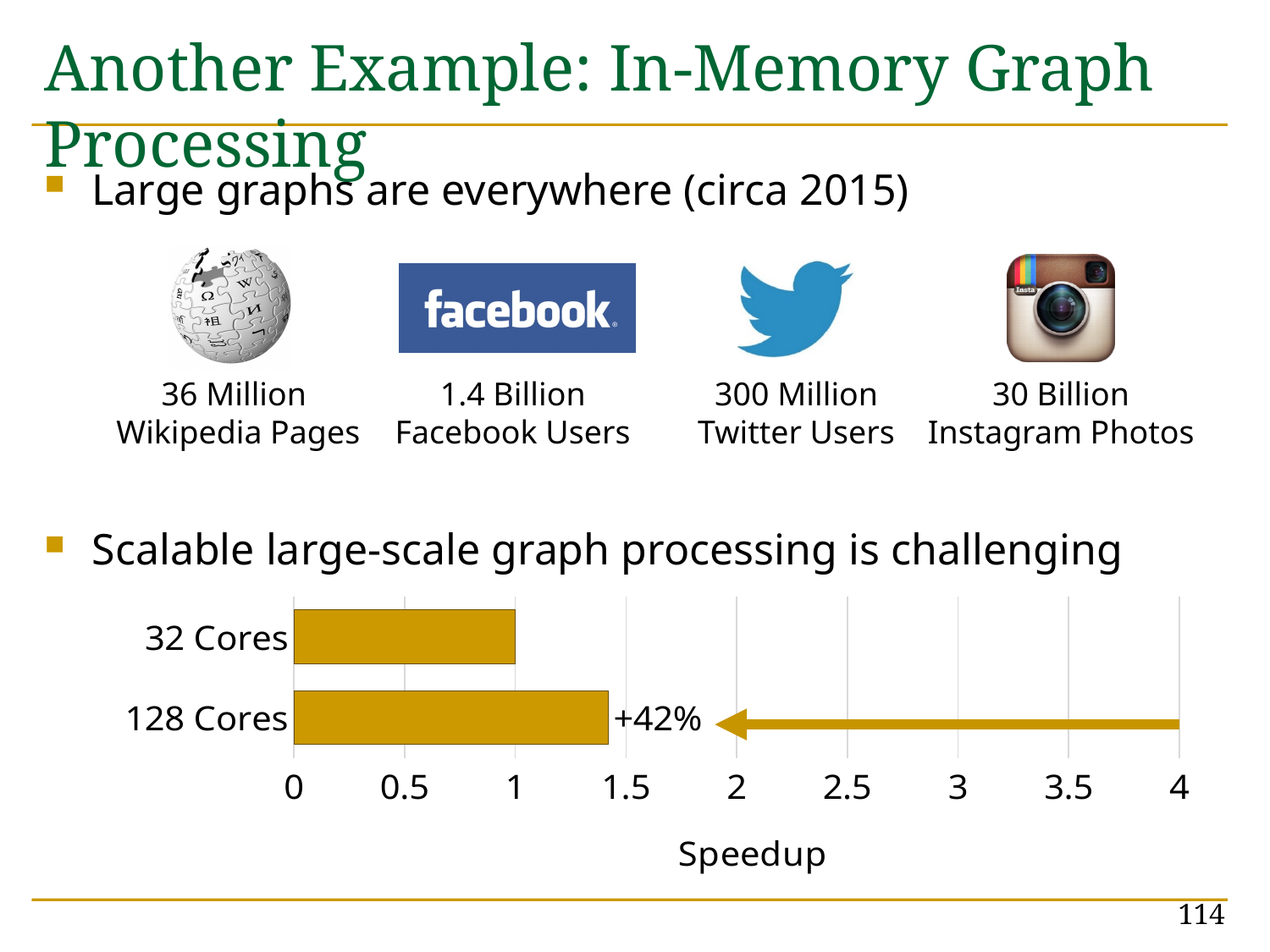
What is the speedup value for 32 Cores? 1 What annotation is printed next to the 128 Cores bar? +42% Is the speedup for 128 Cores greater or less than 1? greater What kind of chart is shown at the bottom of the slide? bar chart Which has a larger speedup, 32 Cores or 128 Cores? 128 Cores Which category has the highest speedup? 128 Cores How many categories are plotted in the Speedup bar chart? 2 What is the label on the x axis of the bar chart? Speedup Which category has the lowest speedup? 32 Cores Is the speedup for 32 Cores greater or less than 2? less Is the speedup for 128 Cores greater or less than 2? less